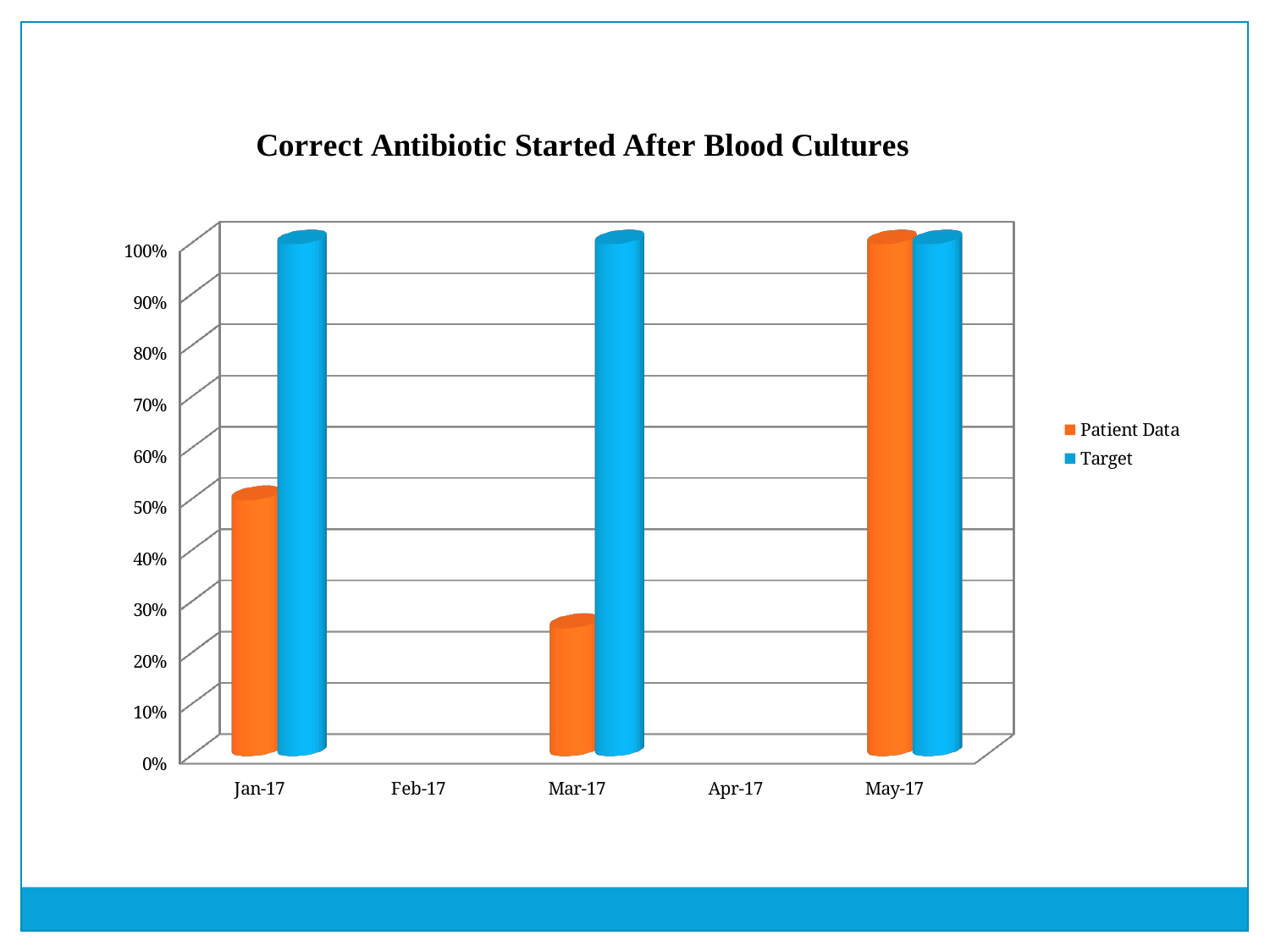
What is the title of the chart? Correct Antibiotic Started After Blood Cultures Which colour represents the Target series? blue Among the months with a Patient Data bar, which has the lowest value? Mar-17 How many months are shown on the x axis? 5 Is the Patient Data value for May-17 greater or less than 90%? greater How many series does the legend list? 2 Is the Patient Data value for Mar-17 greater or less than 30%? less Which is larger, the Patient Data value for Jan-17 or for Mar-17? Jan-17 Is the Patient Data value for Jan-17 greater or less than 40%? greater Which is larger for Jan-17, the Patient Data value or the Target value? Target What kind of chart is shown on the slide? bar chart Which month has the highest Patient Data value? May-17